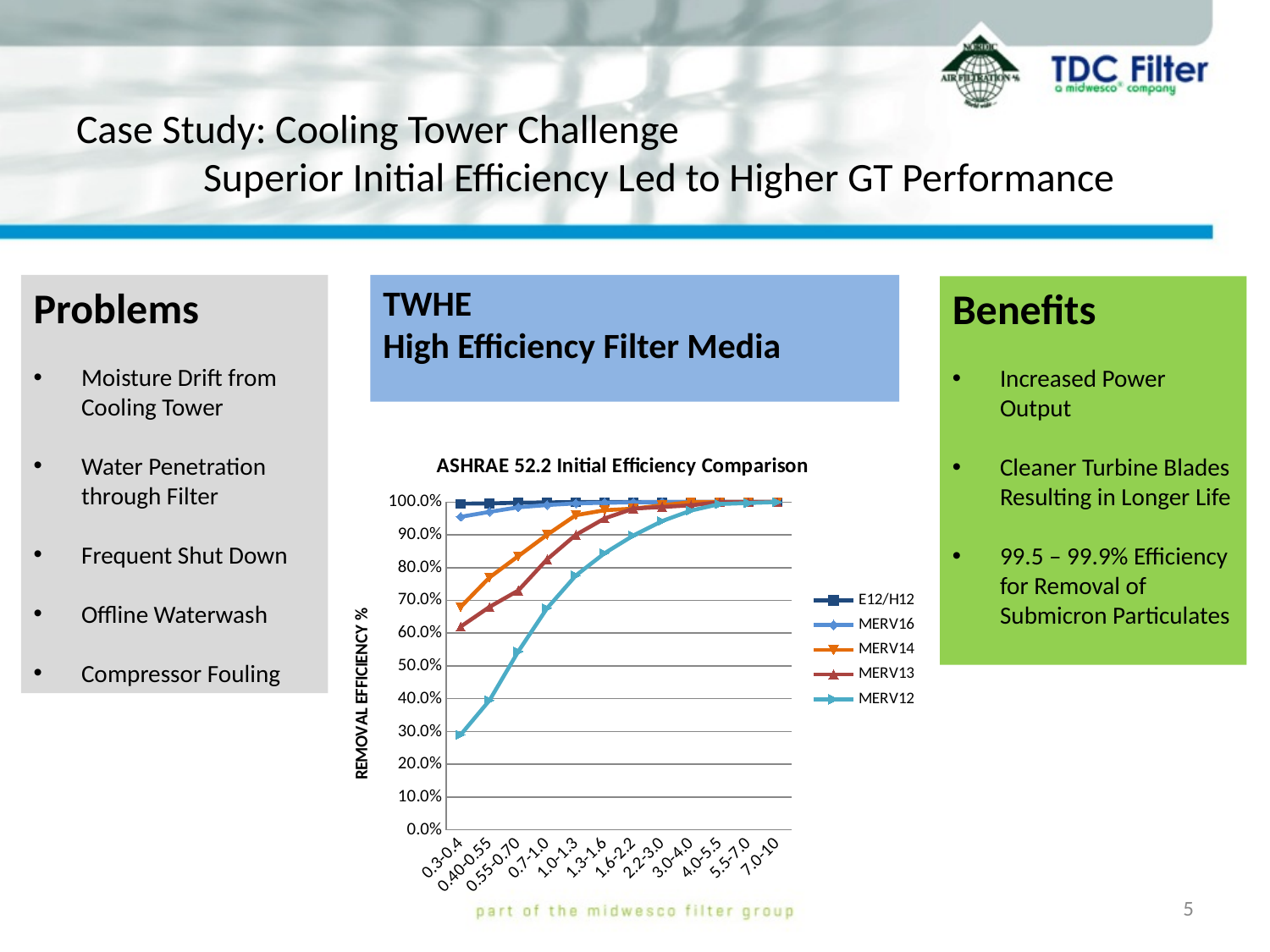
At the 1.0-1.3 category, which is larger, the value for MERV13 or the value for MERV12? MERV13 Is the value for MERV12 at 0.3-0.4 greater or less than 40.0%? less Which series has the highest removal efficiency at the 0.3-0.4 category? E12/H12 Is the value for MERV13 at 0.3-0.4 greater or less than 50.0%? greater How many series does the chart legend list? 5 How many particle size categories are shown on the x axis? 12 What type of chart is shown on the slide? line chart What is the title of the chart? ASHRAE 52.2 Initial Efficiency Comparison Is the value for MERV16 at 0.3-0.4 greater or less than 90.0%? greater Which series has the lowest removal efficiency at the 0.3-0.4 category? MERV12 What is the label of the y axis? REMOVAL EFFICIENCY % Do the MERV12 values rise or fall as the particle size increases along the x axis? rise